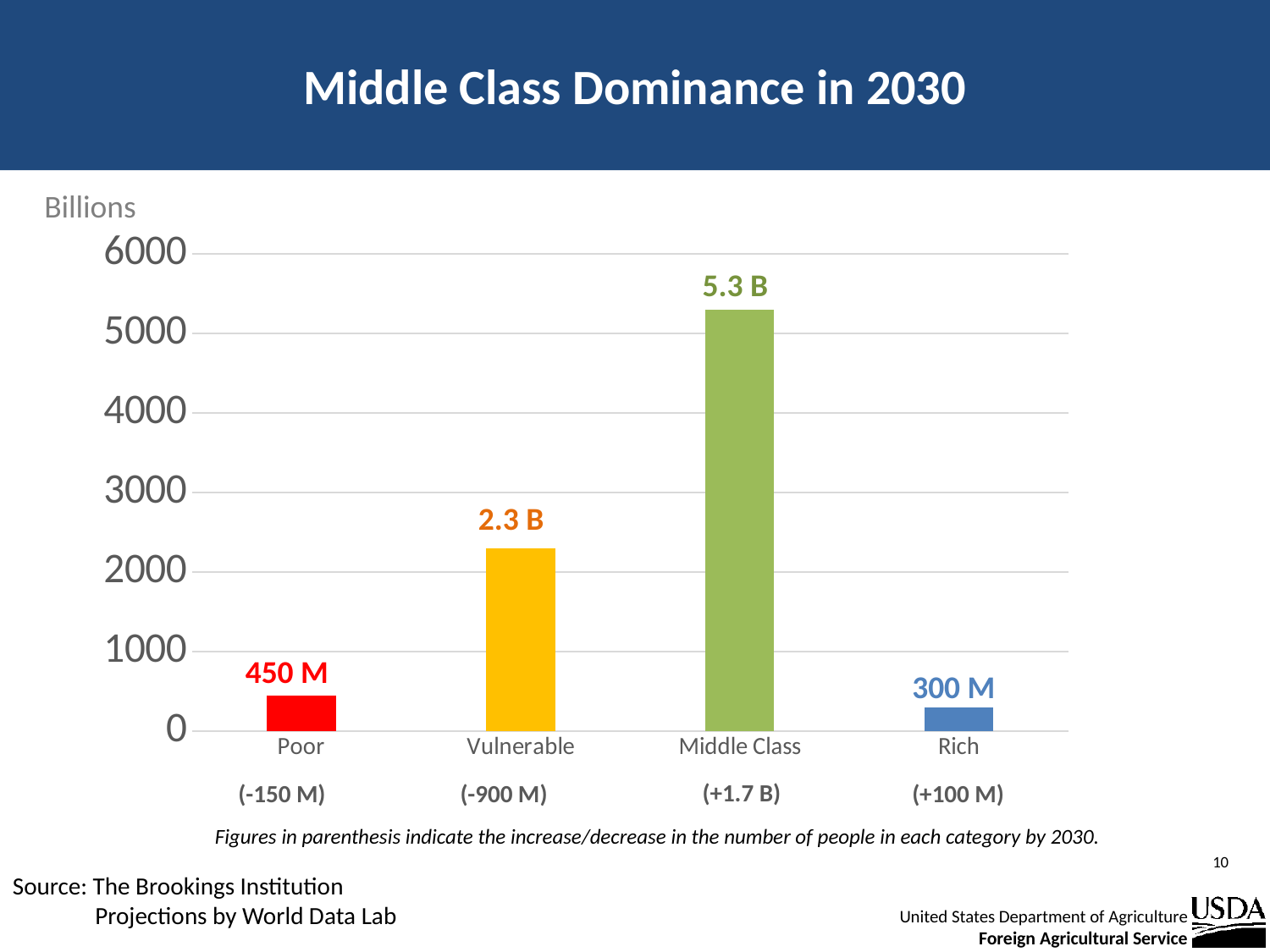
What type of chart is shown on the slide? Bar chart What is the difference between the Middle Class and Vulnerable values? 3.0 B What is the value shown for Vulnerable? 2.3 B Which category has the lowest value? Rich What is the difference between the Poor and Rich values? 150 M Is the value for Middle Class greater or less than 5000 on the axis? greater Which is larger, the value for Poor or the value for Rich? Poor Which category has the highest value? Middle Class What is the value shown for Middle Class? 5.3 B What is the value shown for Poor? 450 M How many categories are shown in the chart? 4 What is the value shown for Rich? 300 M